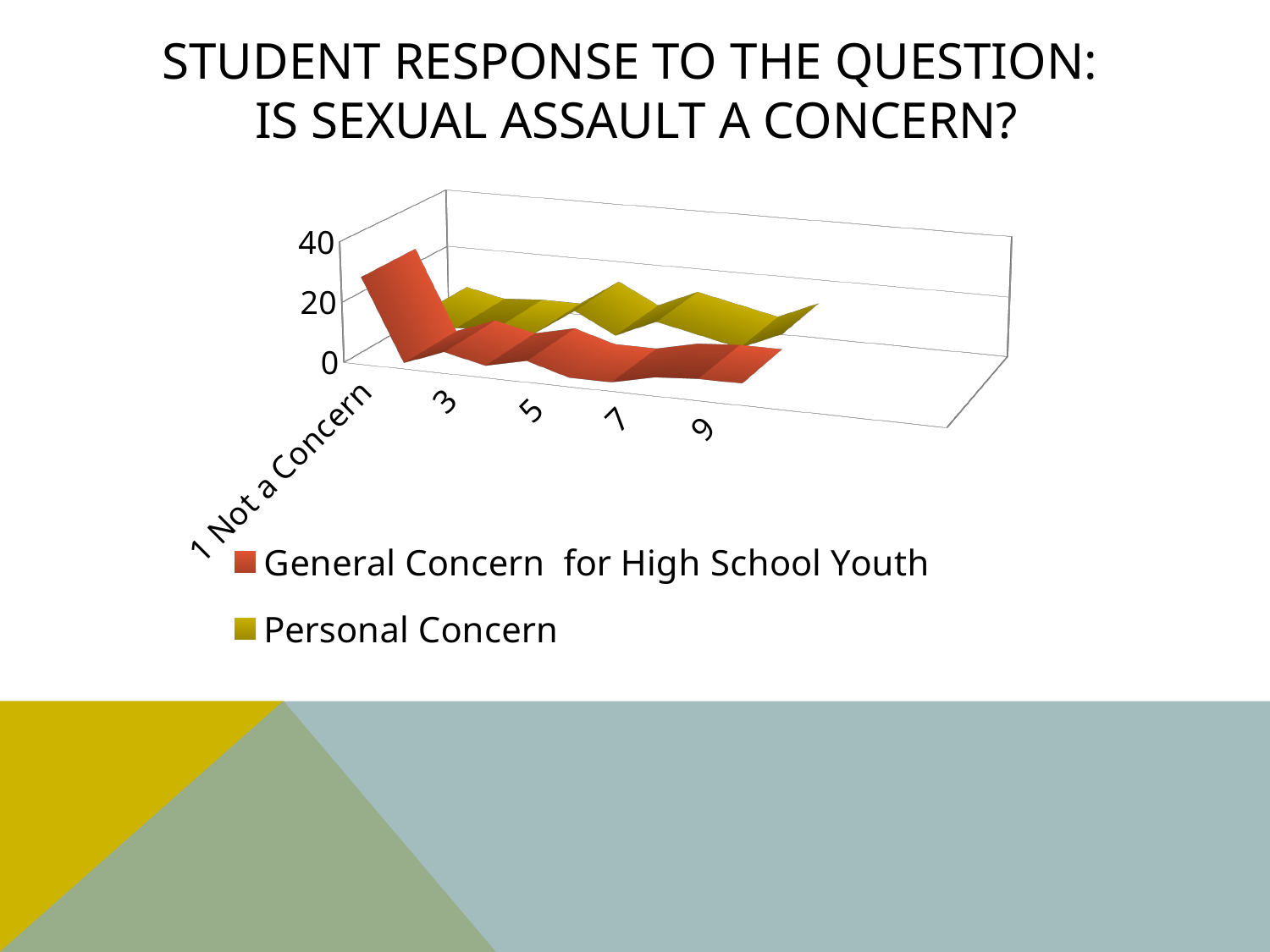
Do the values for General Concern for High School Youth generally rise or fall moving from "1 Not a Concern" toward 9? fall Is the value for General Concern for High School Youth at "1 Not a Concern" greater or less than 20? greater What is the highest value shown on the vertical axis? 40 At "1 Not a Concern", which series has the larger value: General Concern for High School Youth or Personal Concern? General Concern for High School Youth Which colour represents the Personal Concern series? yellow Is the value for General Concern for High School Youth at category 9 greater or less than 20? less What kind of chart is shown on the slide? line chart How many series does the legend list? 2 Which category has the highest value for the General Concern for High School Youth series? 1 Not a Concern